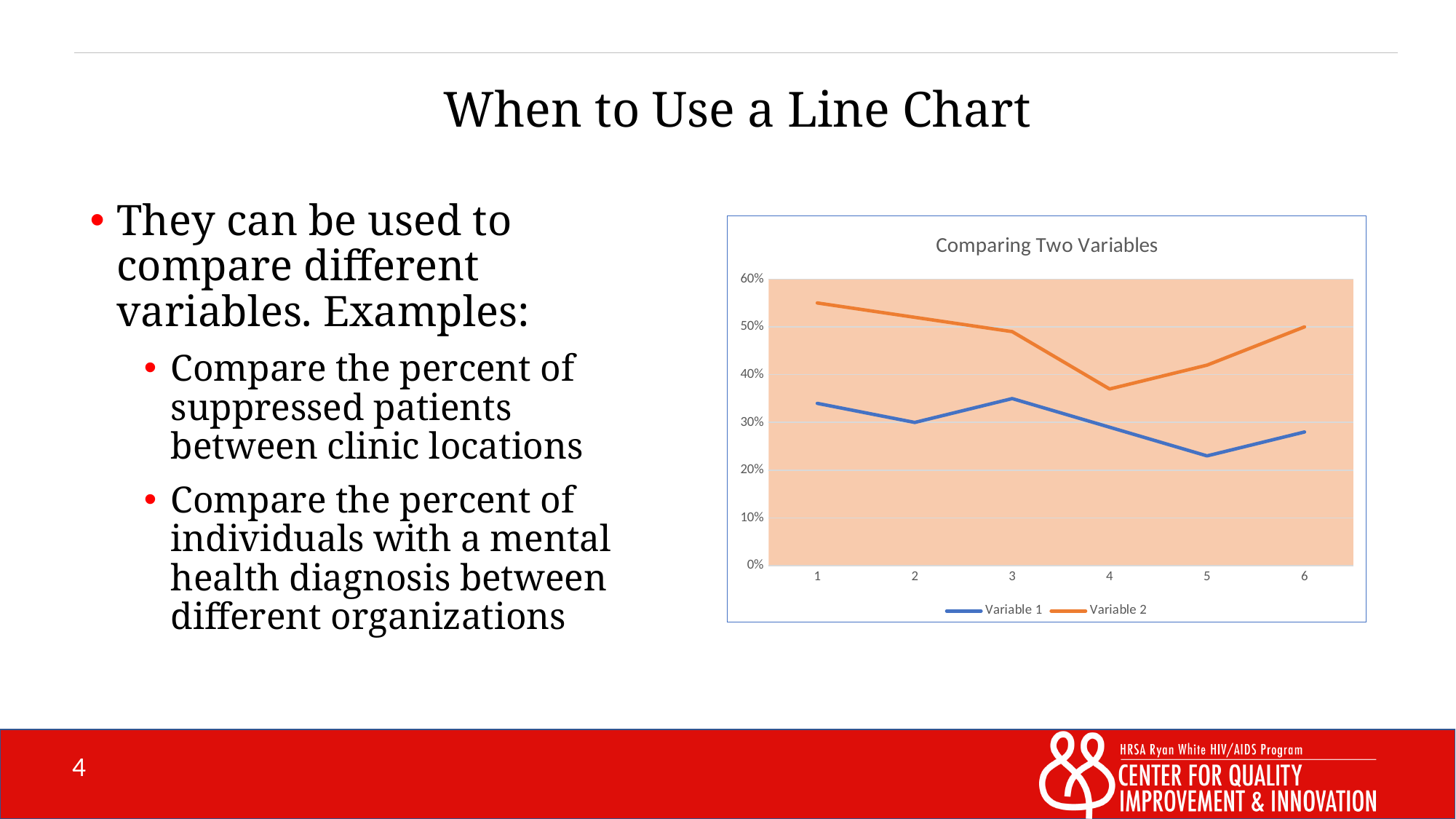
Does Variable 2 rise or fall from x = 1 to x = 4? fall At x = 1, which series has the larger value, Variable 1 or Variable 2? Variable 2 What is the title of the chart? Comparing Two Variables Is the value for Variable 2 at x = 1 greater or less than 50%? greater At which x value does Variable 1 reach its lowest point? 5 At which x value does Variable 2 reach its highest point? 1 Is the value for Variable 1 at x = 5 greater or less than 30%? less Which series is plotted in orange? Variable 2 At which x value does Variable 2 reach its lowest point? 4 How many points are plotted along the x axis for each series? 6 What kind of chart is shown on the slide? line chart How many series does the chart's legend list? 2